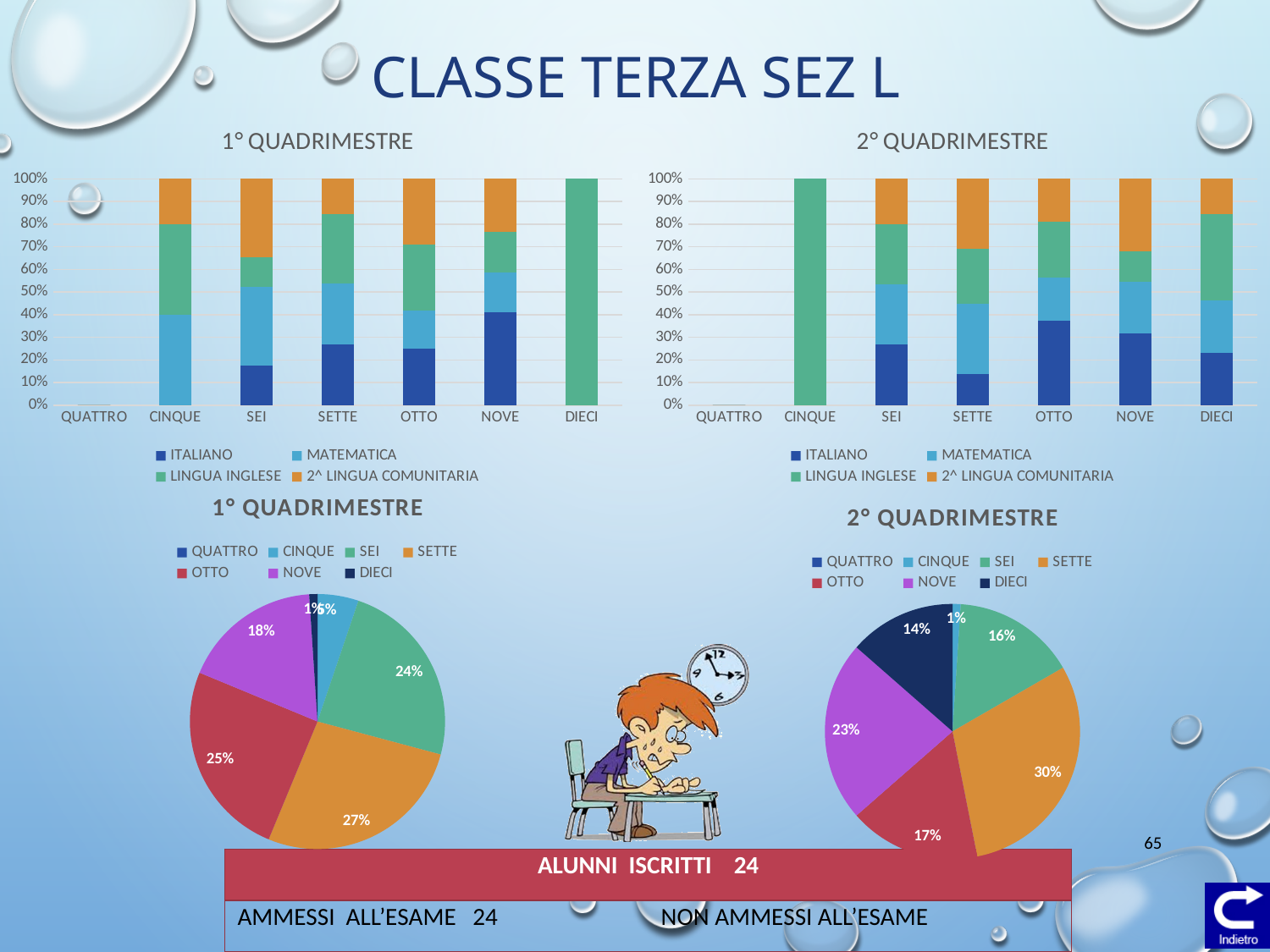
In the 2° QUADRIMESTRE bar chart (top right), is the ITALIANO value for OTTO greater or less than 30%? greater In the 1° QUADRIMESTRE pie chart (bottom left), which grade has the largest slice? SETTE How many categories are shown on the x axis of the 1° QUADRIMESTRE bar chart (top left)? 7 In the 2° QUADRIMESTRE pie chart (bottom right), what percentage is shown for SETTE? 30% In the 1° QUADRIMESTRE pie chart (bottom left), which slice is larger, OTTO or NOVE? OTTO How many series does the legend of the 1° QUADRIMESTRE stacked bar chart (top left) list? 4 What kind of chart is the 1° QUADRIMESTRE chart at the top left of the slide? Stacked bar chart In the 1° QUADRIMESTRE pie chart (bottom left), what percentage is shown for SETTE? 27% In the 2° QUADRIMESTRE pie chart (bottom right), what percentage is shown for NOVE? 23% In the 2° QUADRIMESTRE bar chart (top right), is the ITALIANO value for SETTE greater or less than 20%? less In the 2° QUADRIMESTRE pie chart (bottom right), how many percentage points larger is the SETTE slice than the OTTO slice? 13 percentage points In the 2° QUADRIMESTRE pie chart (bottom right), which labelled slice is the smallest? CINQUE